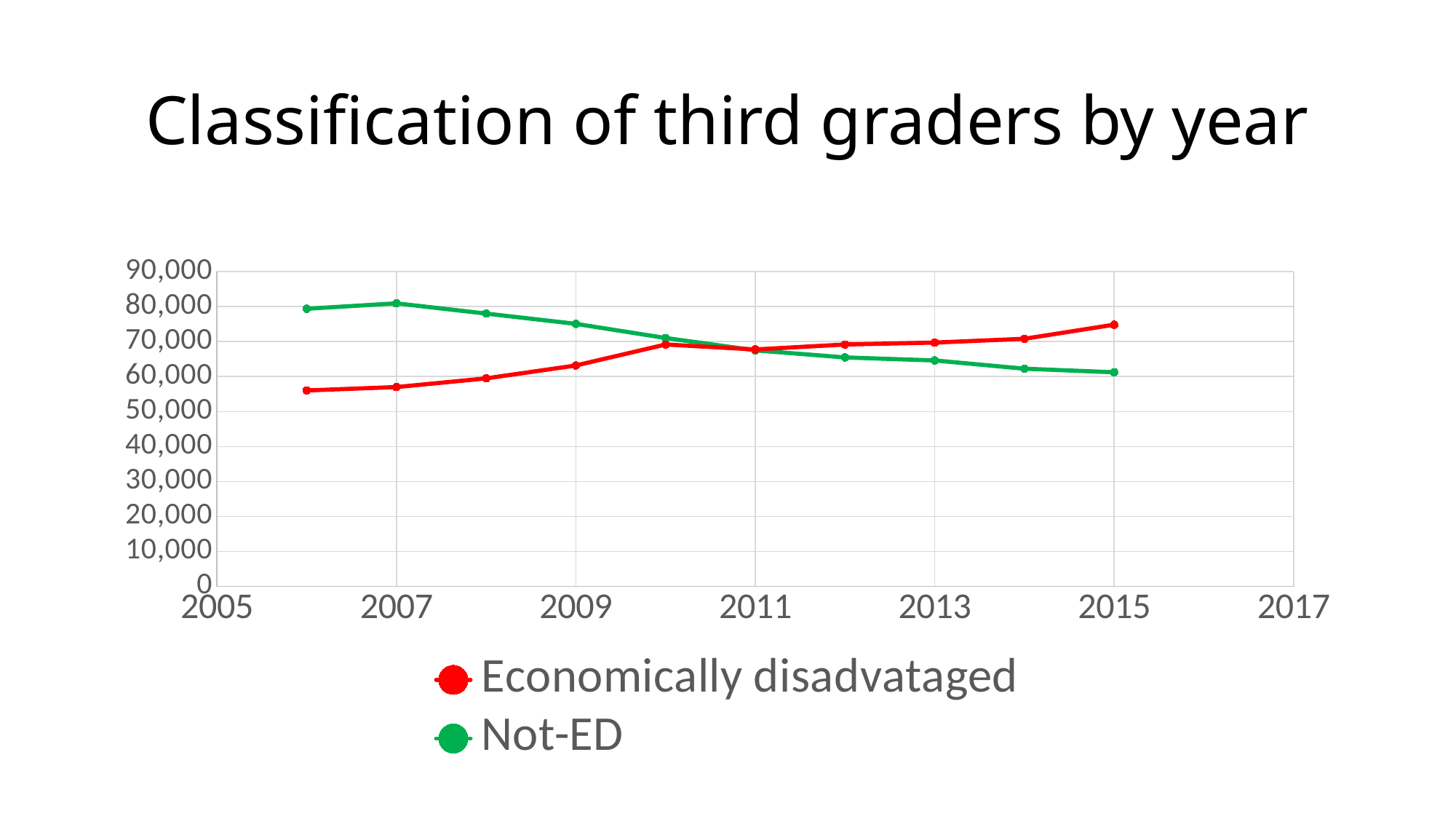
How many series does the legend list? 2 In which year does the Not-ED series reach its highest value? 2007 In 2008, which series has the larger value, Economically disadvataged or Not-ED? Not-ED What is the title of the chart? Classification of third graders by year What kind of chart is shown on the slide? line chart Is the Economically disadvataged value for 2006 greater or less than 60,000? less How many data points are plotted for the Economically disadvataged series? 10 Does the Economically disadvataged series rise or fall from 2006 to 2010? rise Does the Not-ED series rise or fall from 2007 to 2015? fall In 2015, which series has the larger value, Economically disadvataged or Not-ED? Economically disadvataged Which colour is used for the Not-ED series? green